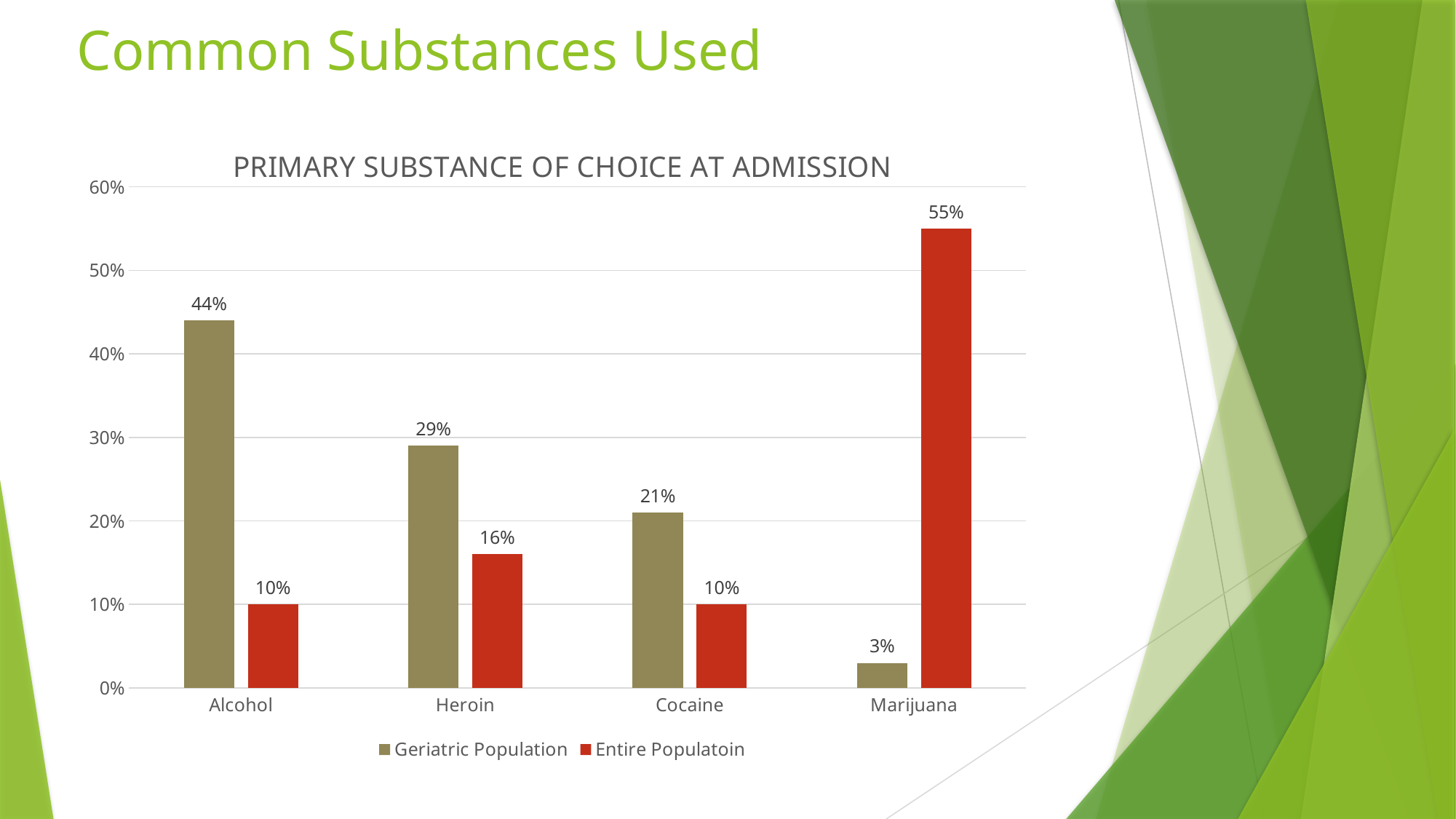
Which category has the highest Entire Populatoin value? Marijuana How many substance categories are shown on the x axis? 4 What kind of chart is shown on the slide? Bar chart For Marijuana, which series has the larger value: Geriatric Population or Entire Populatoin? Entire Populatoin What is the Geriatric Population value for Cocaine? 21% Which category has the highest Geriatric Population value? Alcohol What is the Entire Populatoin value for Marijuana? 55% Which category has the lowest Geriatric Population value? Marijuana How many series does the legend list? 2 What is the title of the chart? PRIMARY SUBSTANCE OF CHOICE AT ADMISSION What is the difference between the Geriatric Population and Entire Populatoin values for Heroin? 13% What is the Geriatric Population value for Alcohol? 44%